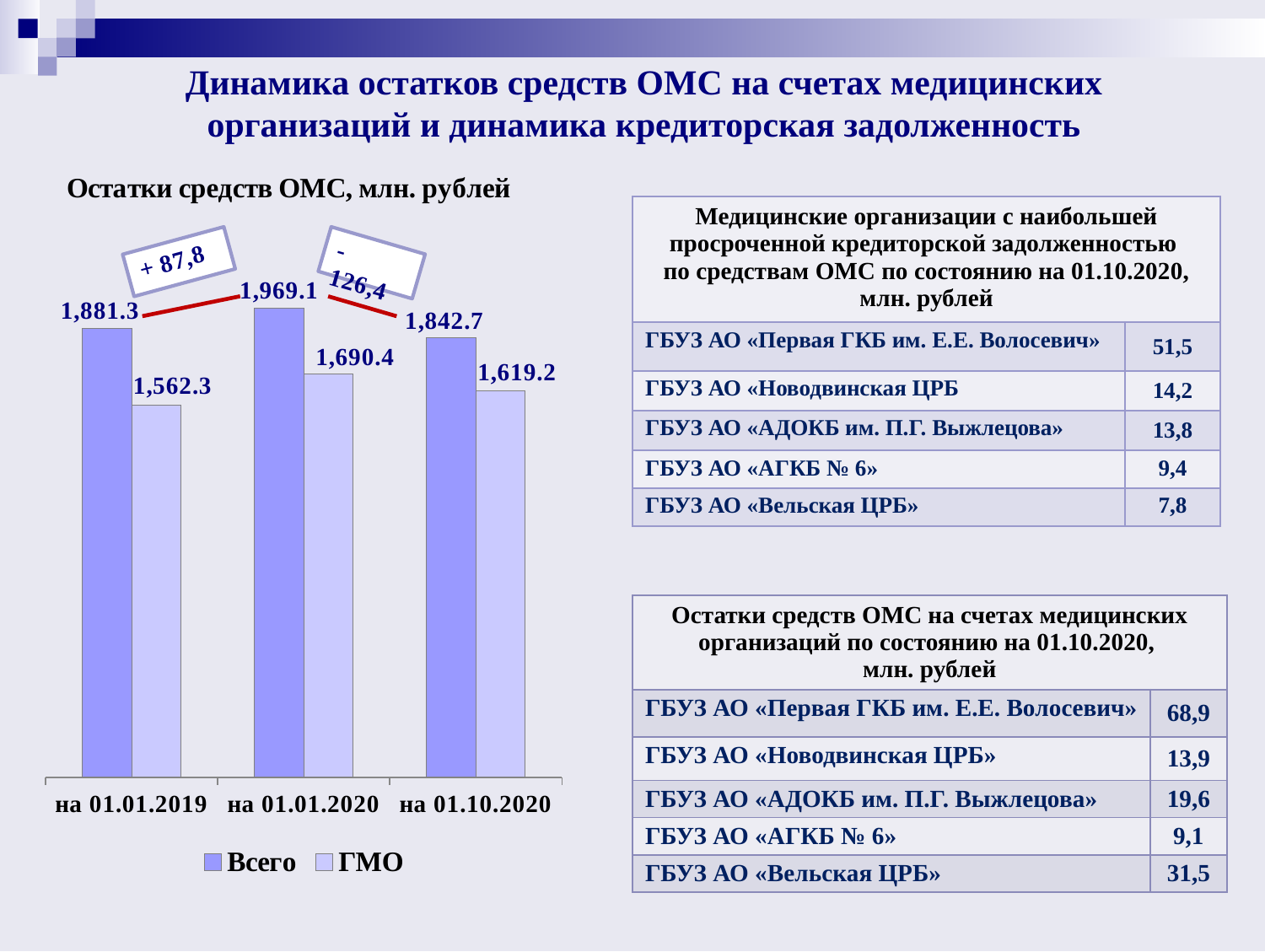
What is the value of the Всего series for на 01.01.2020 in the chart Остатки средств ОМС, млн. рублей? 1,969.1 How many series does the legend of the chart Остатки средств ОМС, млн. рублей list? 2 What is the value of the ГМО series for на 01.01.2019 in the chart Остатки средств ОМС, млн. рублей? 1,562.3 In the chart Остатки средств ОМС, млн. рублей, what is the difference between the Всего values for на 01.01.2020 and на 01.10.2020? 126.4 In the chart Остатки средств ОМС, млн. рублей, what is the difference between the Всего and ГМО values for на 01.01.2019? 319.0 In the chart Остатки средств ОМС, млн. рублей, which date has the lowest value for the ГМО series? на 01.01.2019 In the chart Остатки средств ОМС, млн. рублей, which date has the highest value for the Всего series? на 01.01.2020 What is the value of the ГМО series for на 01.10.2020 in the chart Остатки средств ОМС, млн. рублей? 1,619.2 How many dates (categories) are shown on the x axis of the chart Остатки средств ОМС, млн. рублей? 3 What type of chart is Остатки средств ОМС, млн. рублей? Bar chart In the chart Остатки средств ОМС, млн. рублей, which is larger: the ГМО value for на 01.01.2020 or for на 01.10.2020? на 01.01.2020 What change is shown in the annotation between на 01.01.2019 and на 01.01.2020 in the chart Остатки средств ОМС, млн. рублей? + 87,8